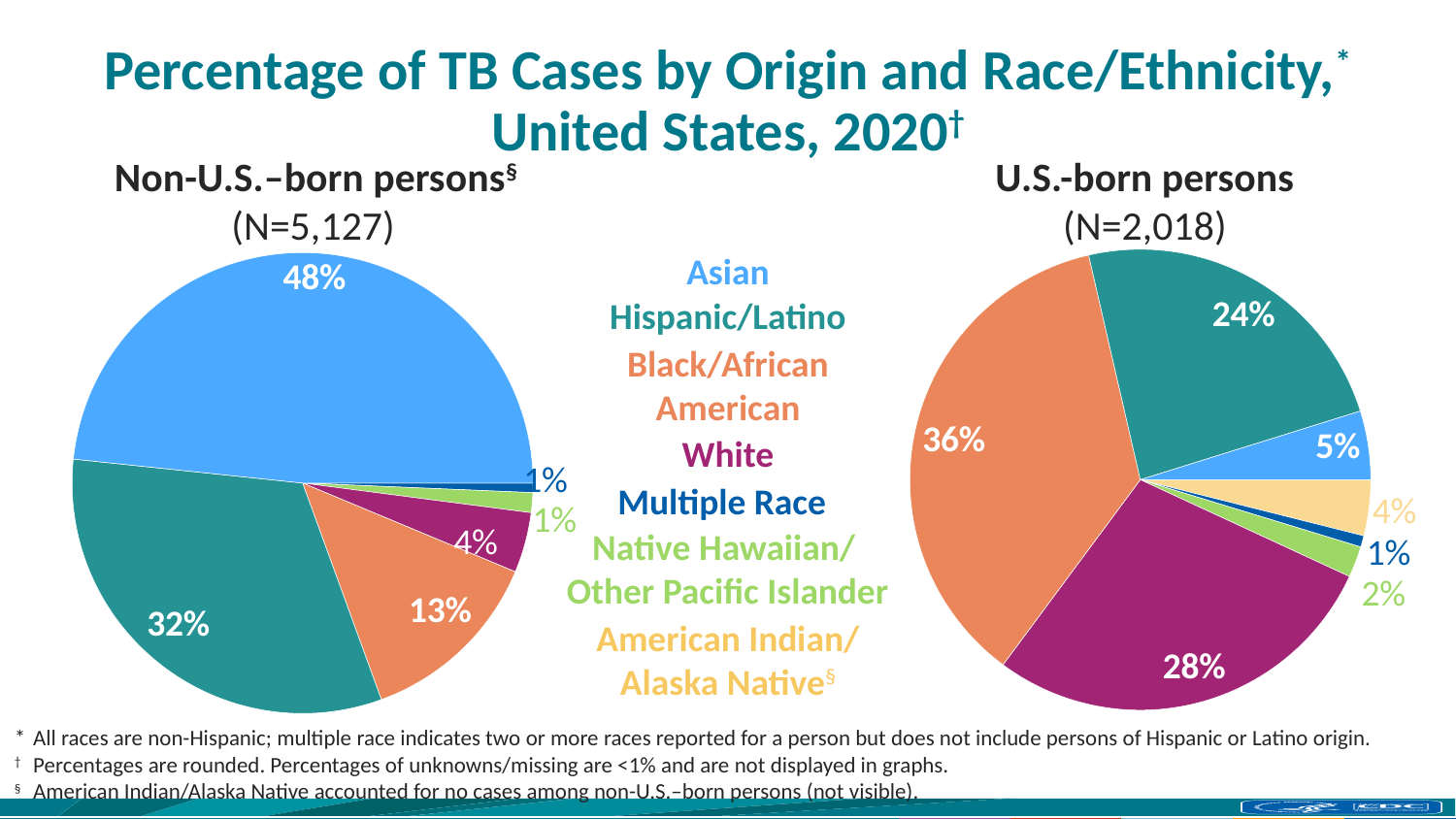
In the U.S.-born persons pie chart, what percentage of TB cases is Black/African American? 36% In the U.S.-born persons pie chart, what percentage of TB cases is American Indian/Alaska Native? 4% In the U.S.-born persons pie chart, what percentage of TB cases is White? 28% In the U.S.-born persons pie chart, which race/ethnicity has the smallest share? Multiple Race In the U.S.-born persons pie chart, which race/ethnicity has the largest share? Black/African American In the Non-U.S.-born persons pie chart, what percentage of TB cases is Hispanic/Latino? 32% What type of chart is used on this slide? Pie chart What is the N value shown for the U.S.-born persons pie chart? N=2,018 In the Non-U.S.-born persons pie chart, what is the difference between the Asian and Hispanic/Latino shares? 16% In the U.S.-born persons pie chart, which is larger: the Hispanic/Latino share or the White share? White In the Non-U.S.-born persons pie chart, which race/ethnicity has the largest share? Asian In the Non-U.S.-born persons pie chart, what percentage of TB cases is Asian? 48%